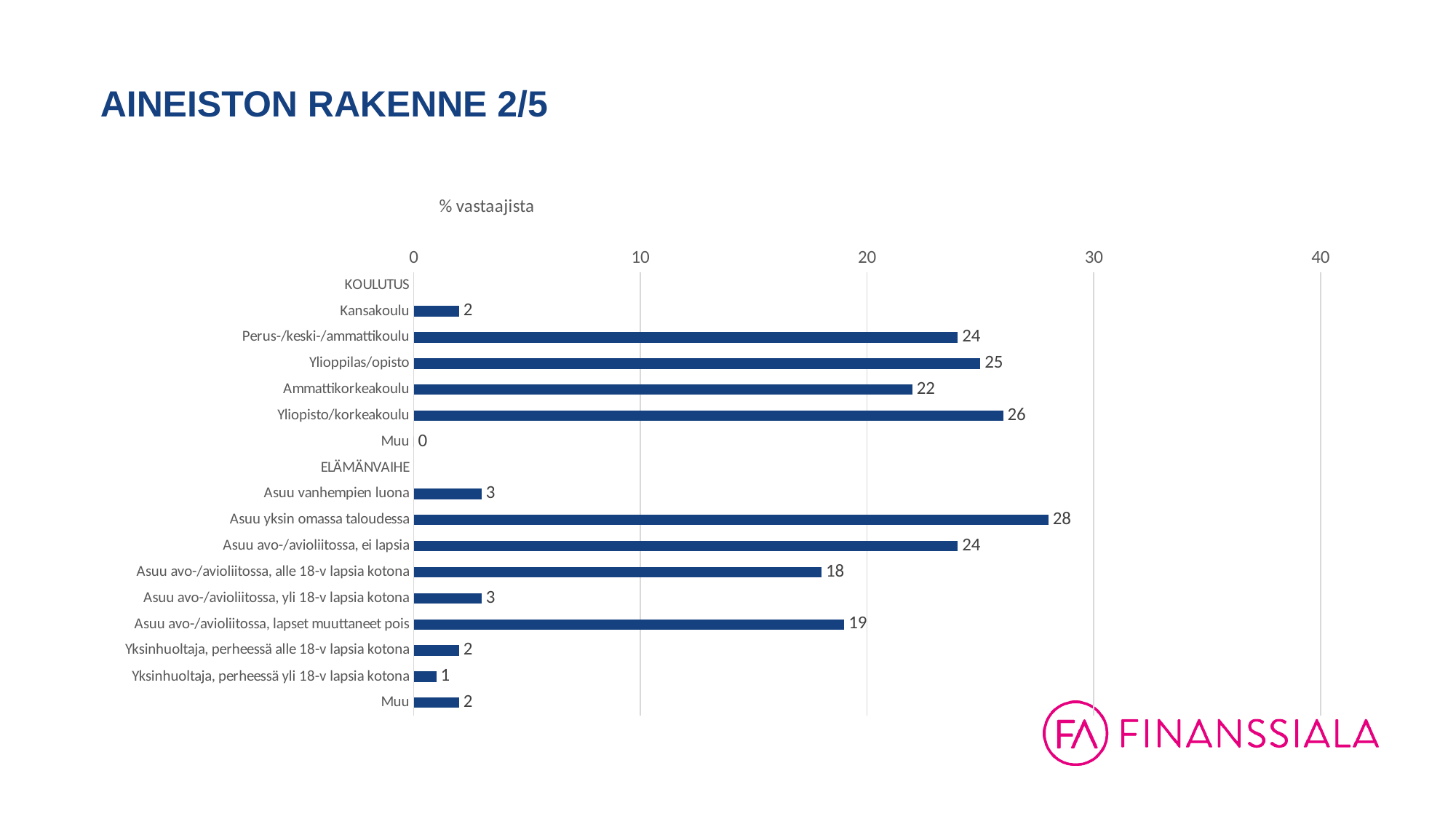
What kind of chart is shown on the slide? bar chart What is the value for Yliopisto/korkeakoulu? 26 What is the value for Asuu yksin omassa taloudessa? 28 Is the value for Asuu avo-/avioliitossa, lapset muuttaneet pois greater or less than 20? less What is the value for Yksinhuoltaja, perheessä yli 18-v lapsia kotona? 1 Which category in the ELÄMÄNVAIHE section has the lowest value? Yksinhuoltaja, perheessä yli 18-v lapsia kotona What is the title shown above the chart's axis? % vastaajista What is the value for Asuu avo-/avioliitossa, alle 18-v lapsia kotona? 18 What is the difference between the values for Asuu yksin omassa taloudessa and Asuu avo-/avioliitossa, ei lapsia? 4 Which is larger, the value for Ylioppilas/opisto or the value for Ammattikorkeakoulu? Ylioppilas/opisto How many categories are listed under the KOULUTUS section? 6 Which category in the KOULUTUS section has the highest value? Yliopisto/korkeakoulu